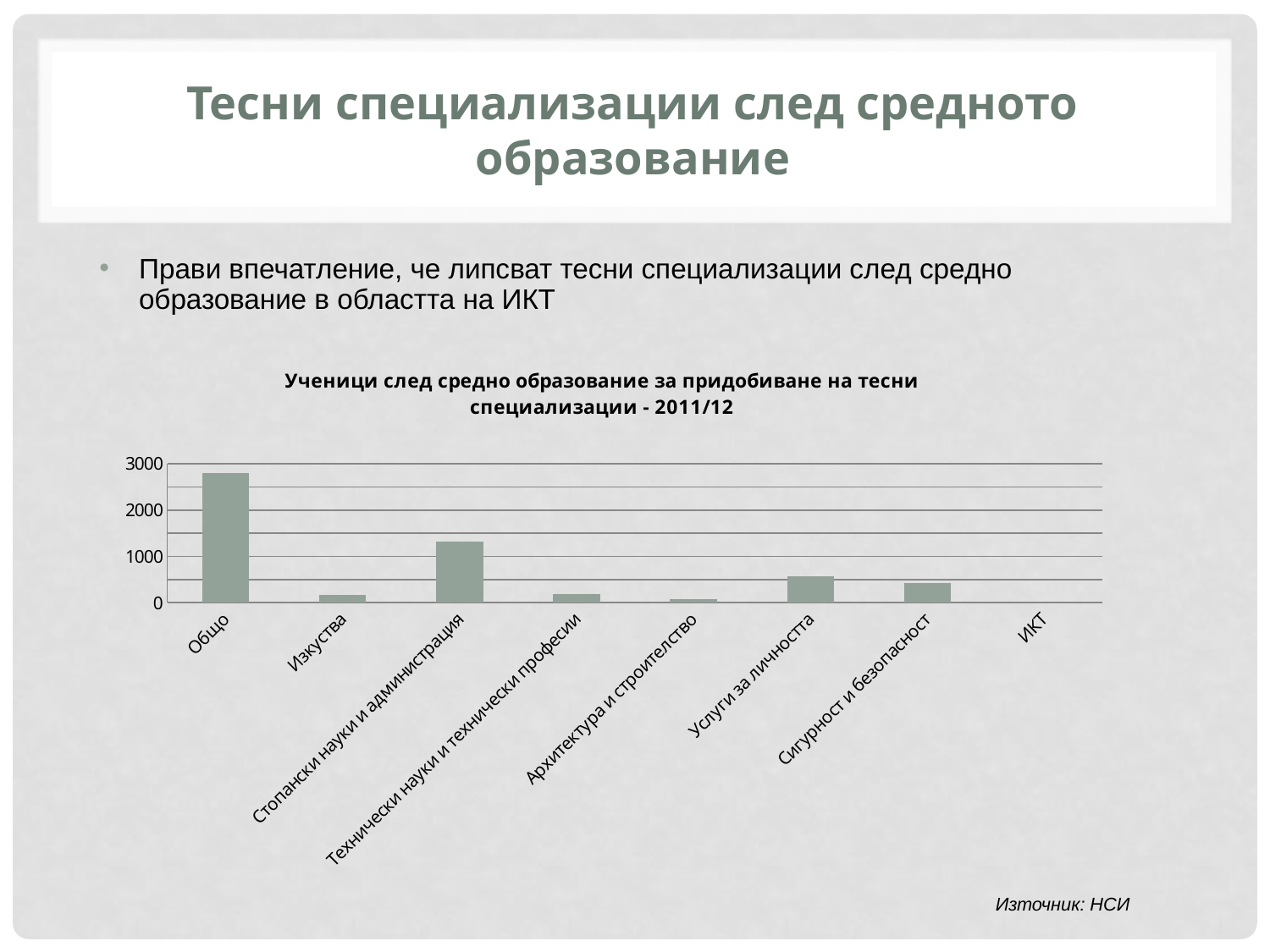
What source is cited for the chart data? НСИ Which is larger, the value for Стопански науки и администрация or the value for Услуги за личността? Стопански науки и администрация Is the value for Изкуства greater or less than 1000? less Is the value for Общо greater or less than 2000? greater What kind of chart is shown on the slide? Bar chart Which category has the highest bar in the chart? Общо Is the value for Стопански науки и администрация greater or less than 1000? greater How many categories are shown on the x axis of the chart? 8 Which is larger, the value for Общо or the value for Сигурност и безопасност? Общо What is the title of the chart? Ученици след средно образование за придобиване на тесни специализации - 2011/12 Which category has the lowest value in the chart? ИКТ